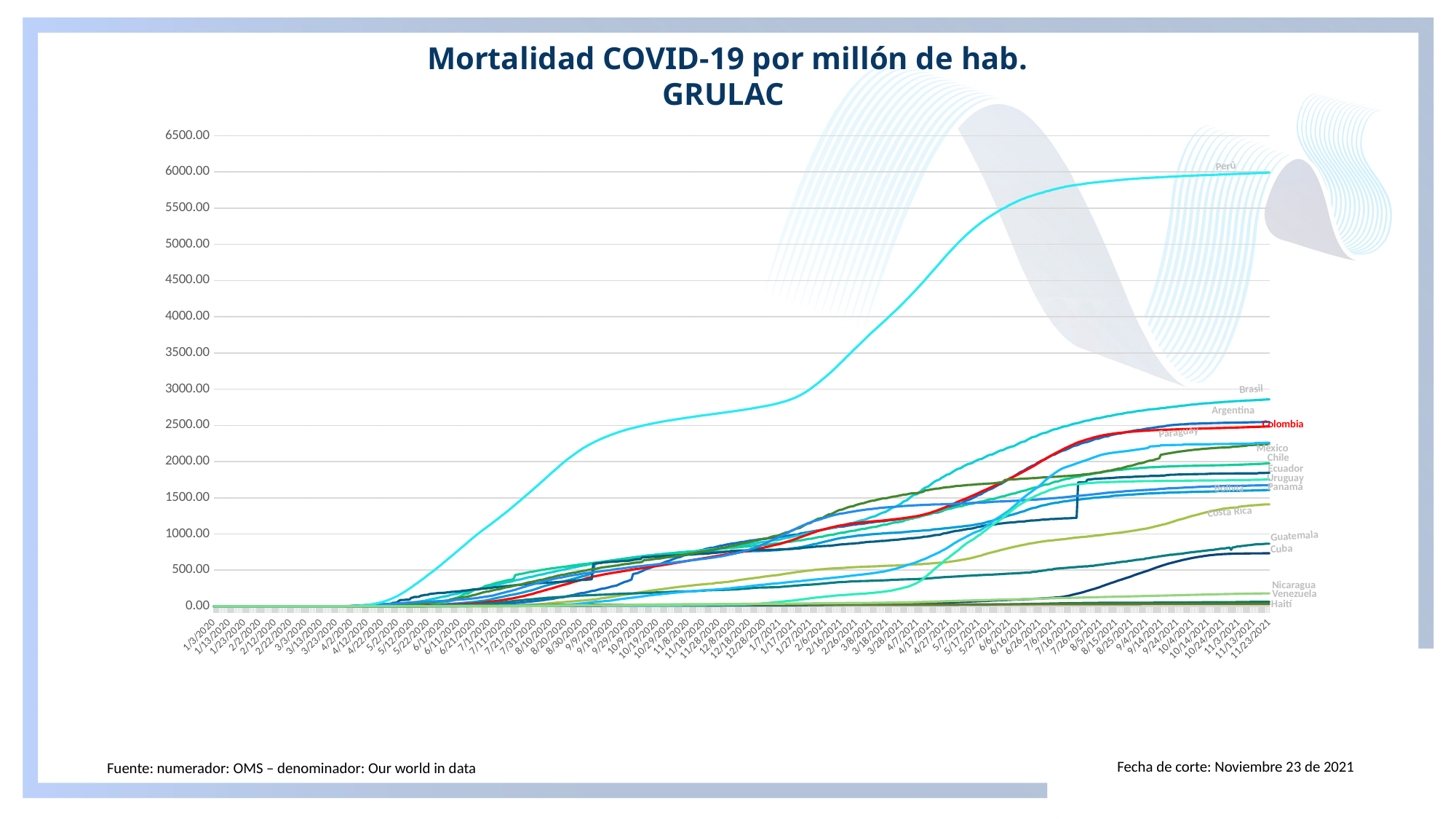
What kind of chart is shown on the slide? line chart Is the final value for Guatemala greater or less than 1000? less At the end of the series, which is higher: Costa Rica or Guatemala? Costa Rica Which country has the lowest COVID-19 mortality per million at the end of the series? Haití Is the final value for Perú greater or less than 5500? greater Which country has the highest COVID-19 mortality per million at the end of the series? Perú Which country's line is drawn in red? Colombia Is the final value for Nicaragua greater or less than 500? less Does the line for Perú rise or fall over time along the x axis? rise At the end of the series, which is higher: Brasil or Argentina? Brasil